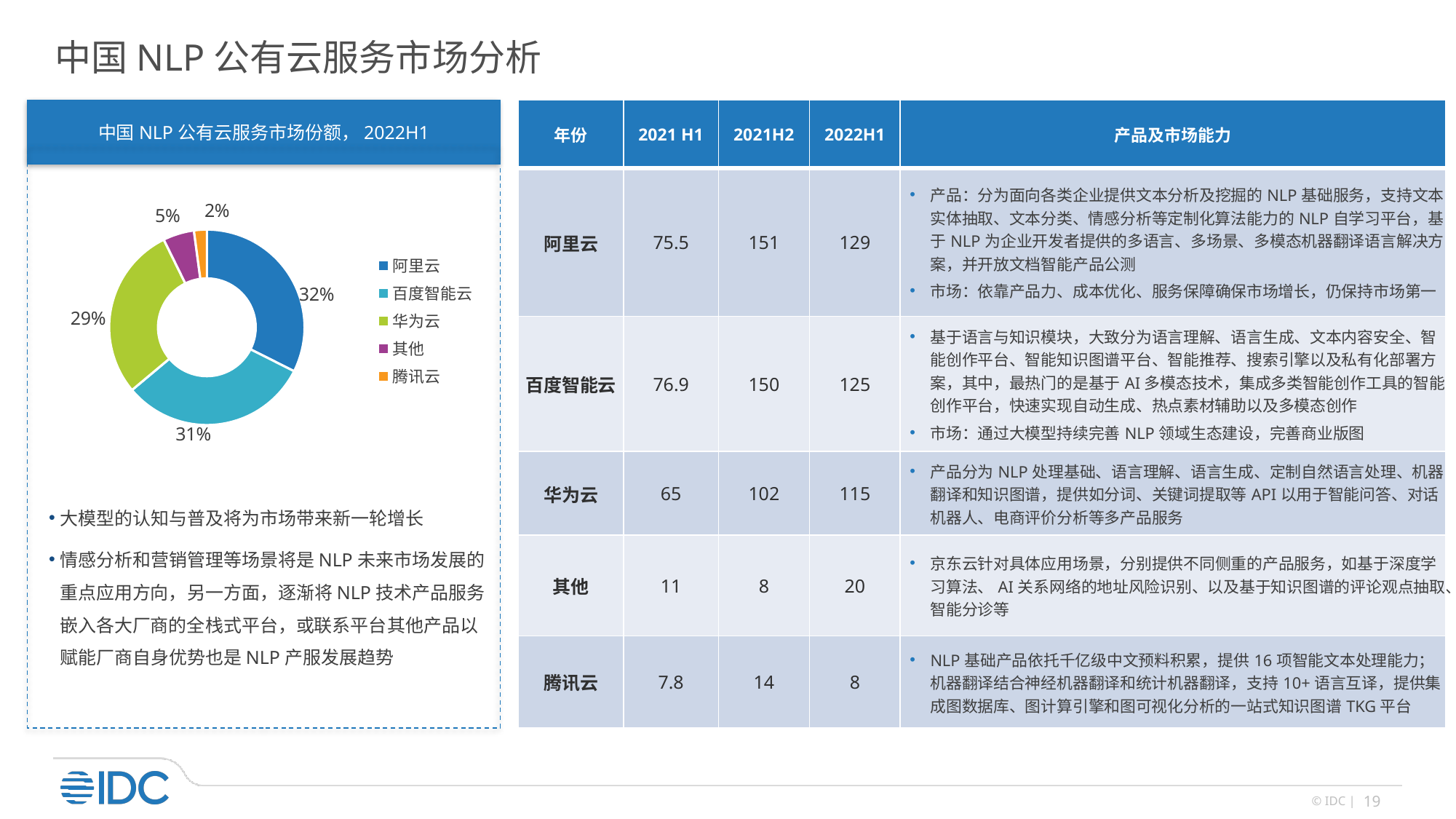
What is the market share of 华为云 in the pie chart? 29% What is the market share of 腾讯云 in the pie chart? 2% What is the market share of 阿里云 in the pie chart? 32% Which category has the smallest share in the pie chart? 腾讯云 Which has a larger share, 其他 or 腾讯云? 其他 How many categories does the pie chart legend list? 5 What type of chart is shown on the slide? Pie chart (donut) What share does 其他 hold in the pie chart? 5% What is the difference in share between 阿里云 and 华为云? 3% What is the title of the pie chart? 中国 NLP 公有云服务市场份额，2022H1 Which category has the largest share in the pie chart? 阿里云 What is the market share of 百度智能云 in the pie chart? 31%